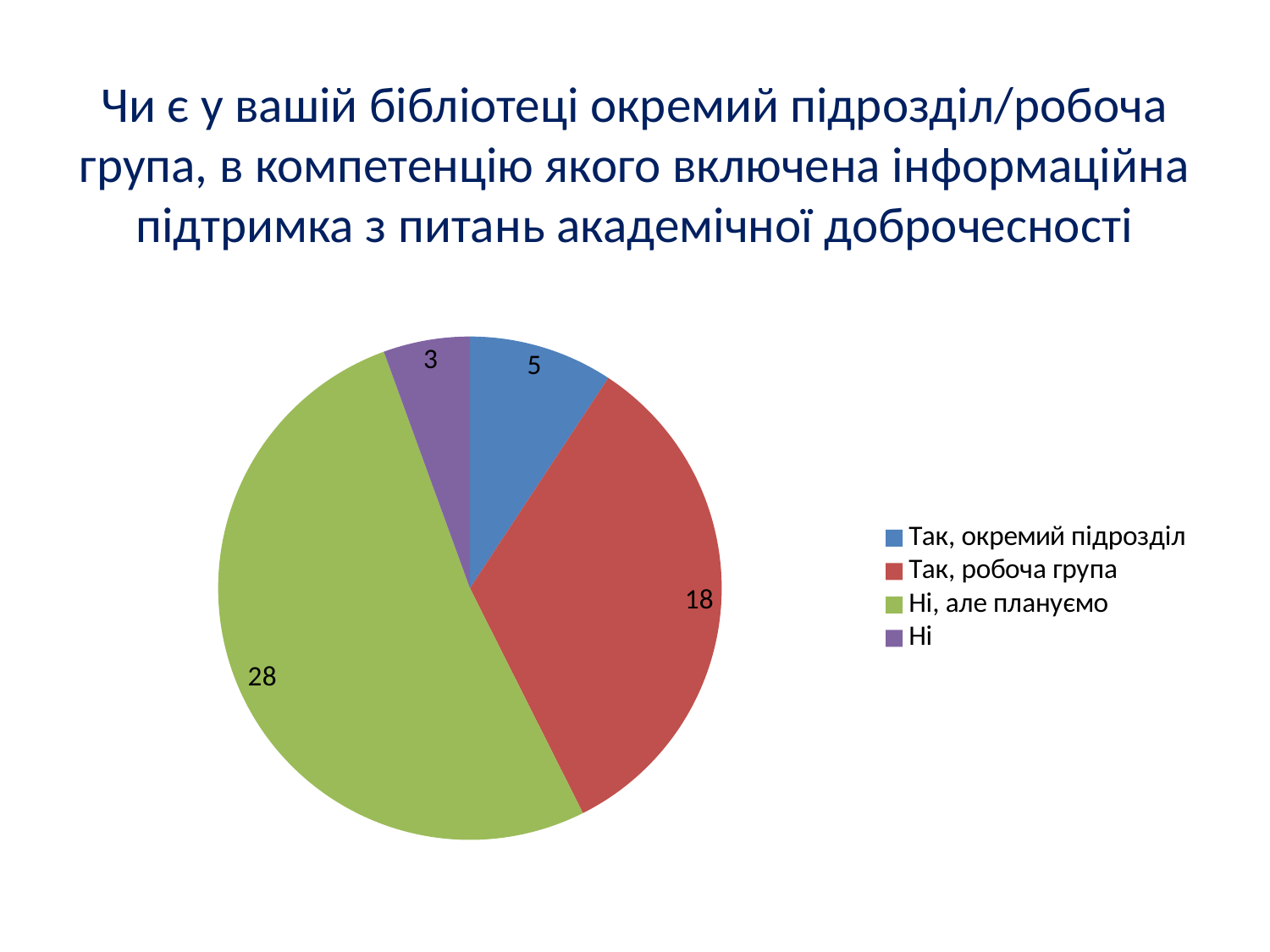
How many slices does the pie chart have? 4 What is the total of all four slices in the pie chart? 54 What is the value for "Так, робоча група"? 18 Which category has the smallest slice? Ні What is the value for "Ні"? 3 What kind of chart is shown on the slide? pie chart What is the difference between the values for "Ні, але плануємо" and "Так, робоча група"? 10 Which category has the largest slice? Ні, але плануємо What is the value for "Так, окремий підрозділ"? 5 Which is larger, the value for "Так, окремий підрозділ" or the value for "Ні"? Так, окремий підрозділ What is the value for "Ні, але плануємо"? 28 How many entries does the legend list? 4